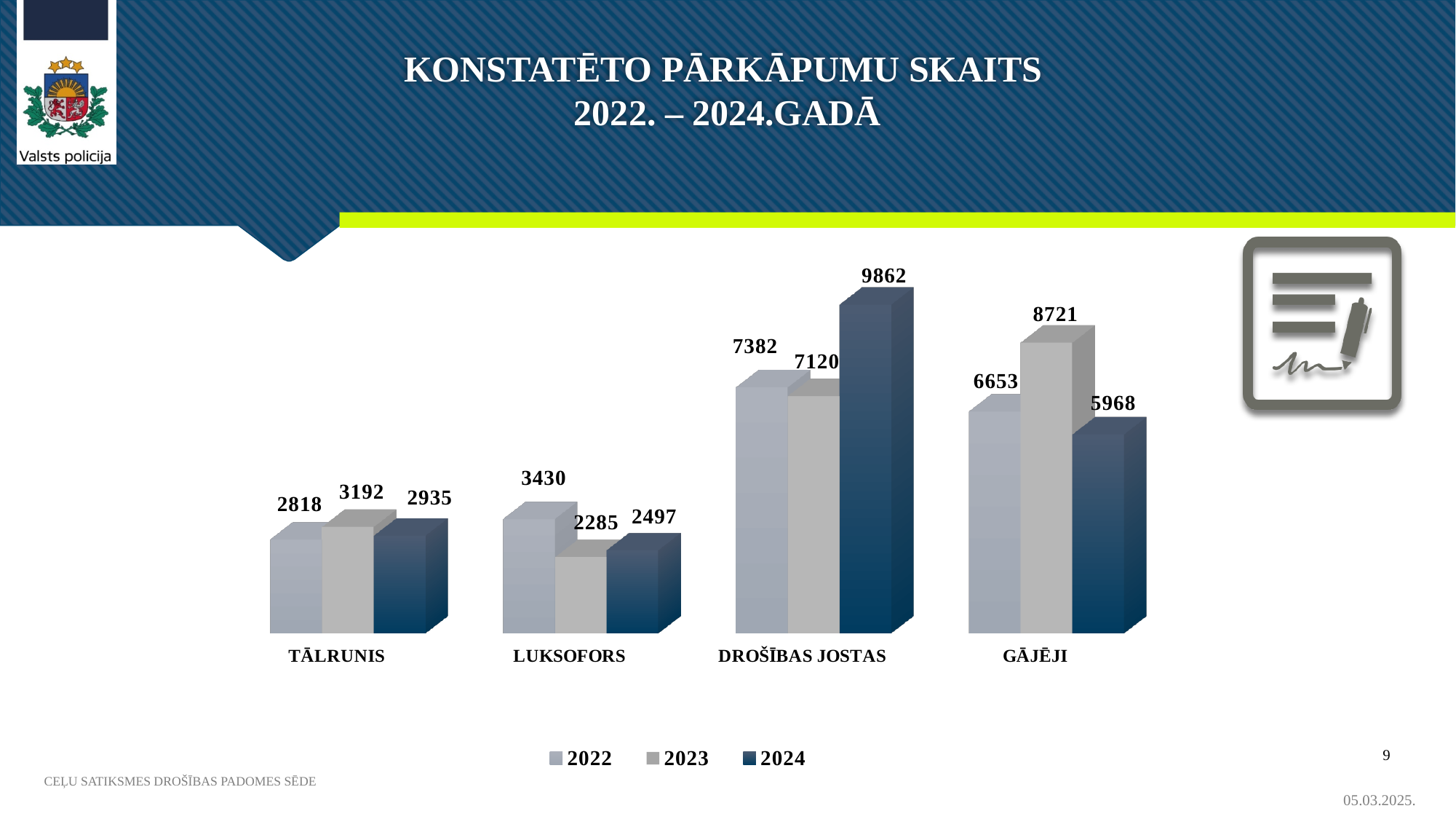
How many categories are shown on the x axis? 4 Which is larger for GĀJĒJI: the 2022 value or the 2024 value? 2022 What is the difference between the 2024 and 2023 values for DROŠĪBAS JOSTAS? 2742 What is the value for GĀJĒJI in 2023? 8721 Which category has the lowest value in 2022? TĀLRUNIS What kind of chart is shown on the slide? Bar chart What is the value for TĀLRUNIS in 2022? 2818 How many series does the legend list? 3 Which category has the highest value in 2024? DROŠĪBAS JOSTAS What is the value for LUKSOFORS in 2023? 2285 What is the title of the chart? KONSTATĒTO PĀRKĀPUMU SKAITS 2022. – 2024.GADĀ What is the value for DROŠĪBAS JOSTAS in 2024? 9862